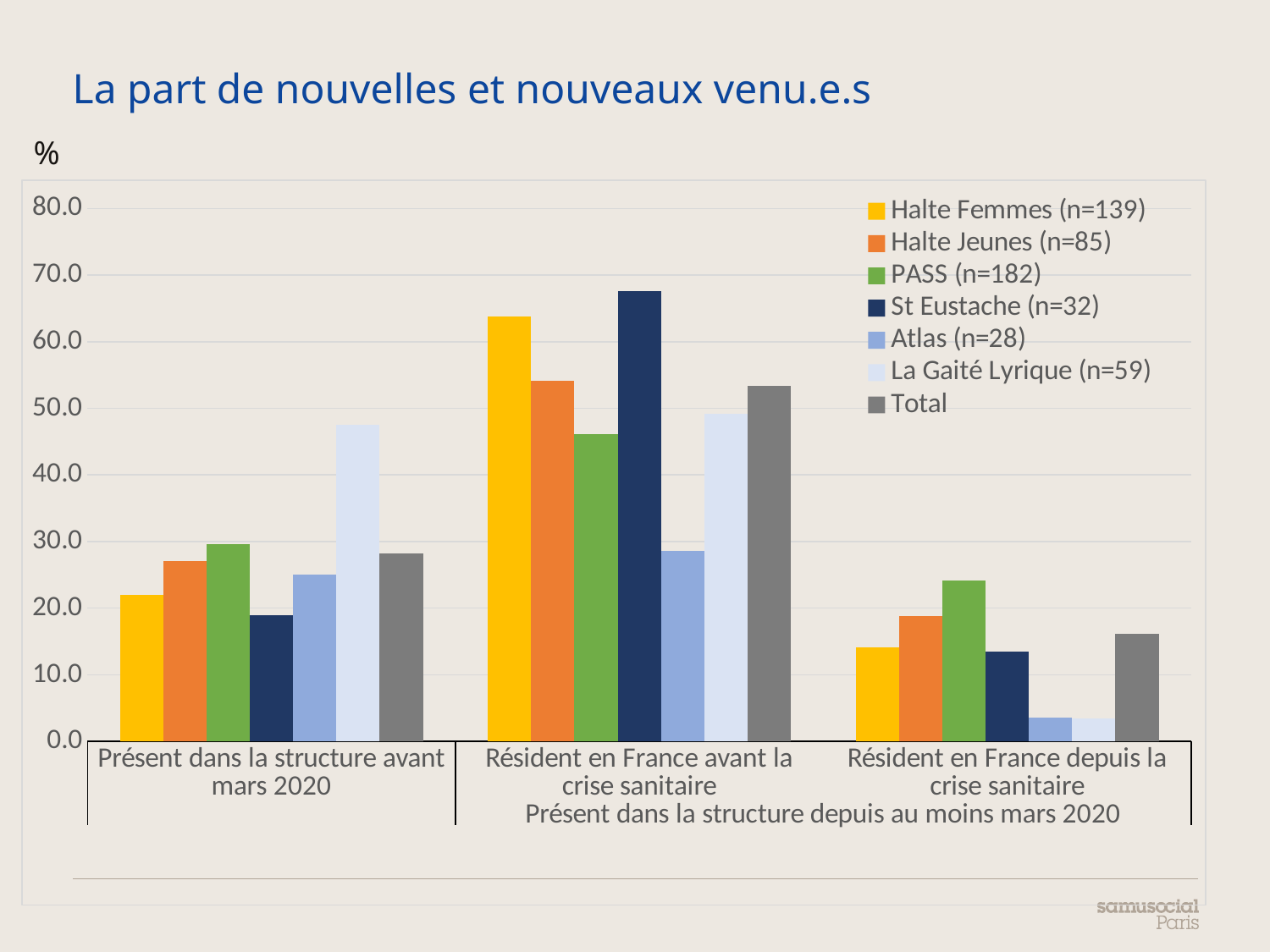
Which series has the lowest value for 'Présent dans la structure avant mars 2020'? St Eustache (n=32) Is the value for Atlas in 'Résident en France depuis la crise sanitaire' greater or less than 10.0? less What kind of chart is shown on the slide? bar chart Is the value for Total in 'Résident en France avant la crise sanitaire' greater or less than 50.0? greater How many categories are shown along the x axis? 3 Which series has the highest value for 'Présent dans la structure avant mars 2020'? La Gaité Lyrique (n=59) What sample size (n) does the legend give for PASS? 182 How many series does the legend list? 7 Is the value for Halte Femmes in 'Résident en France avant la crise sanitaire' greater or less than 60.0? greater In 'Résident en France avant la crise sanitaire', which is larger: Halte Jeunes or PASS? Halte Jeunes Which series has the highest value for 'Résident en France depuis la crise sanitaire'? PASS (n=182) Which series has the highest value for 'Résident en France avant la crise sanitaire'? St Eustache (n=32)